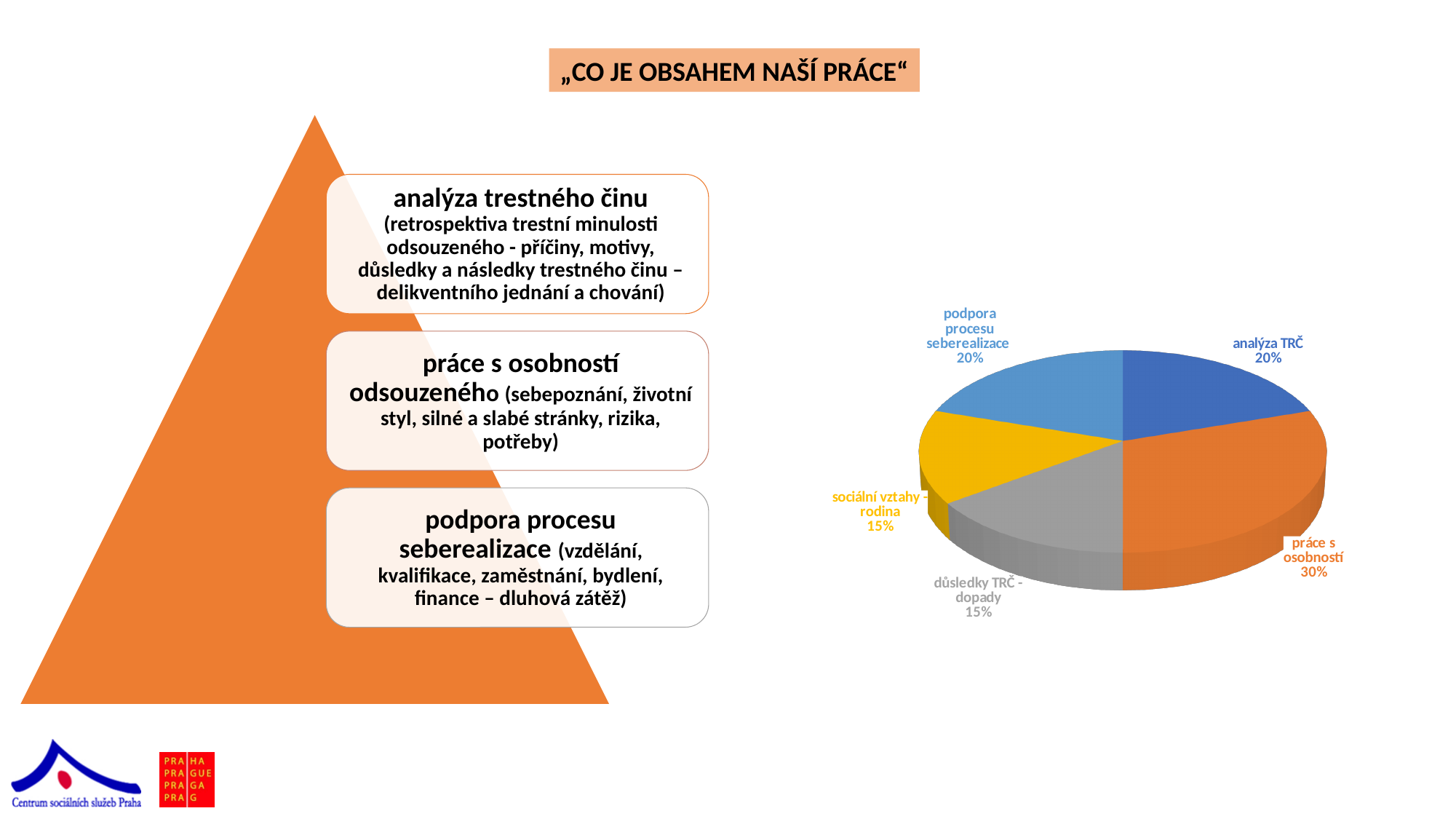
Which is larger in the pie chart: "podpora procesu seberealizace" or "důsledky TRČ - dopady"? podpora procesu seberealizace What percentage is shown for "sociální vztahy – rodina" in the pie chart? 15% What colour is the "práce s osobností" slice in the pie chart? orange What is the combined share of "analýza TRČ" and "práce s osobností"? 50% What percentage is shown for "důsledky TRČ - dopady" in the pie chart? 15% What percentage is shown for "analýza TRČ" in the pie chart? 20% How many slices does the pie chart have? 5 What share of the pie chart does "práce s osobností" represent? 30% Which category has the largest slice in the pie chart? práce s osobností What kind of chart is shown on the right side of the slide? pie chart What percentage is shown for "podpora procesu seberealizace" in the pie chart? 20% What is the difference in percentage points between "práce s osobností" and "analýza TRČ"? 10